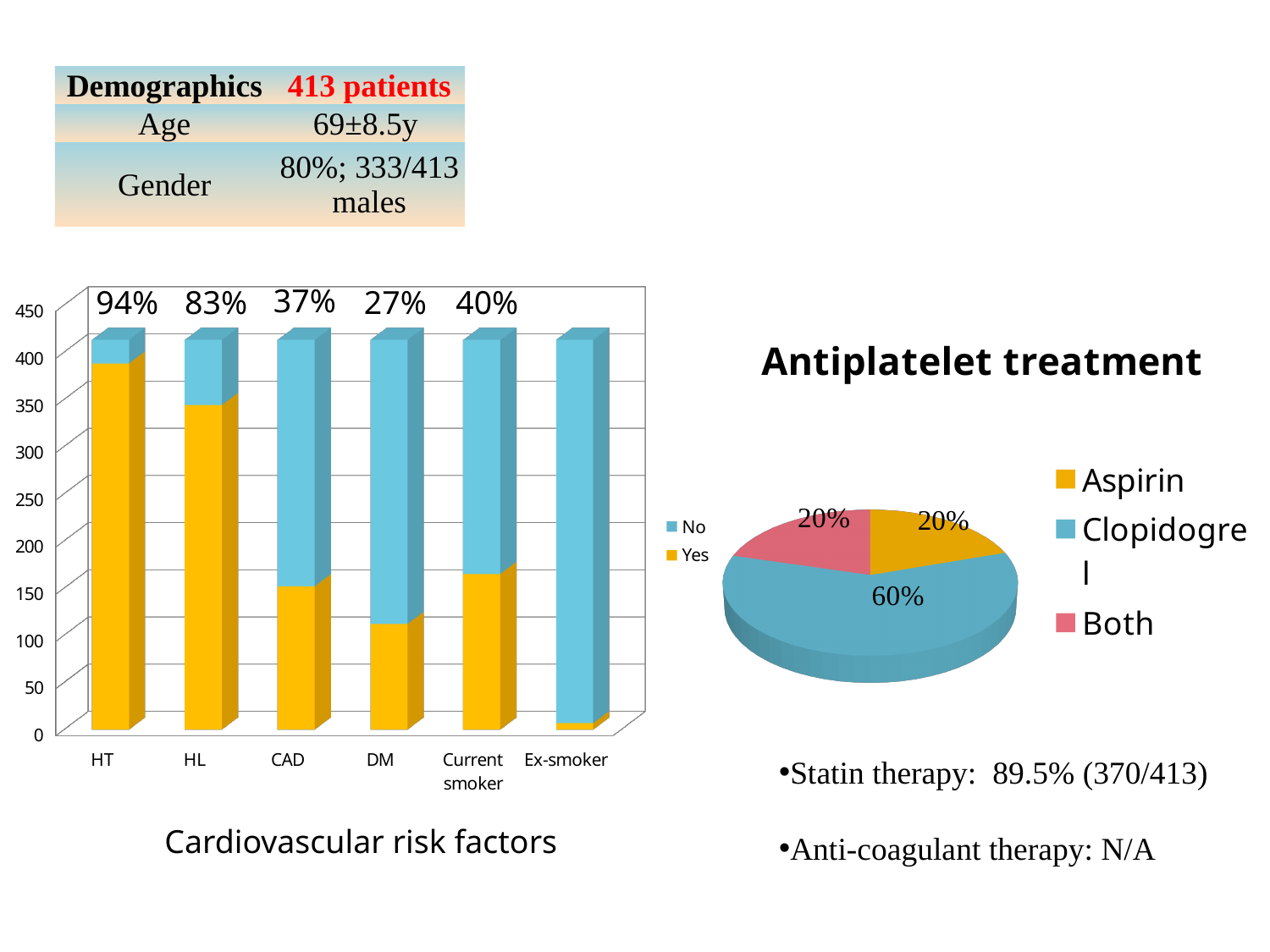
How many categories are shown on the x axis of the Cardiovascular risk factors chart? 6 In the Cardiovascular risk factors chart, what percentage is printed above the HT bar? 94% In the Cardiovascular risk factors chart, is the Yes value for HT greater or less than 350? greater In the Cardiovascular risk factors chart, is the Yes value for DM greater or less than 150? less How many series does the legend of the Cardiovascular risk factors chart list? 2 In the Antiplatelet treatment chart, what share does Clopidogrel have? 60% In the Antiplatelet treatment chart, which category has the largest slice? Clopidogrel In the Cardiovascular risk factors chart, which has the larger Yes value, HT or HL? HT In the Cardiovascular risk factors chart, what is the difference between the percentages printed above the HT and HL bars? 11% What kind of chart is the Cardiovascular risk factors chart? bar chart What kind of chart is the Antiplatelet treatment chart? pie chart In the Cardiovascular risk factors chart, what percentage is printed above the DM bar? 27%